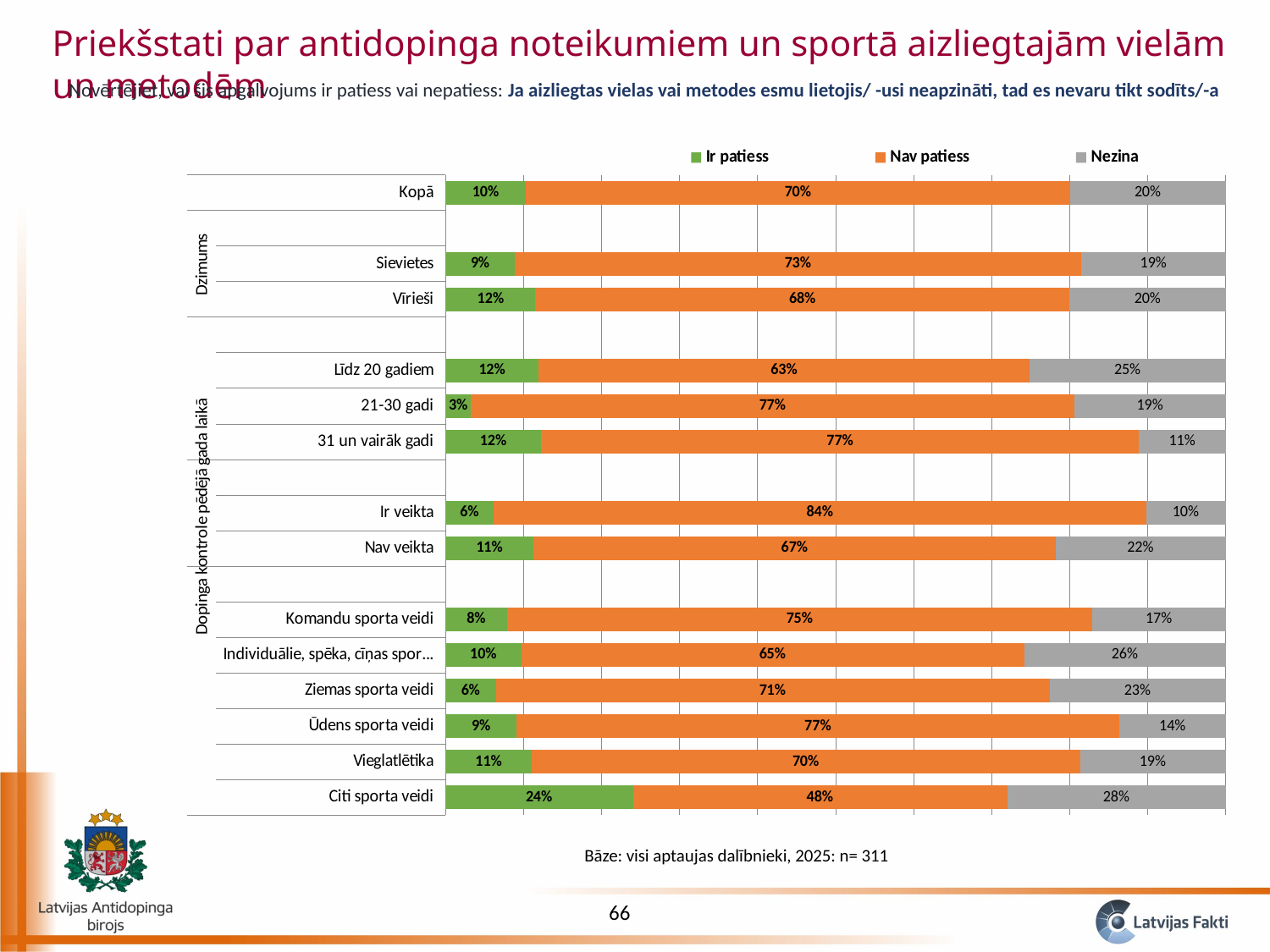
What is the "Nezina" value for Līdz 20 gadiem? 25% What is the "Ir patiess" value for Citi sporta veidi? 24% What is the "Nav patiess" value for Kopā? 70% Which category has the highest "Nav patiess" value? Ir veikta What is the total of the stacked bar for Ir veikta? 100% What kind of chart is shown on the slide? Stacked bar chart Which category has the lowest "Ir patiess" value? 21-30 gadi What is the difference between the "Nav patiess" values for Sievietes and Vīrieši? 5% How many categories are shown in the chart? 14 Which is larger: the "Nezina" value for Individuālie, spēka, cīņas spor... or for Ūdens sporta veidi? Individuālie, spēka, cīņas spor... How many series does the legend list? 3 Which colour represents the "Nezina" series in the chart? Grey